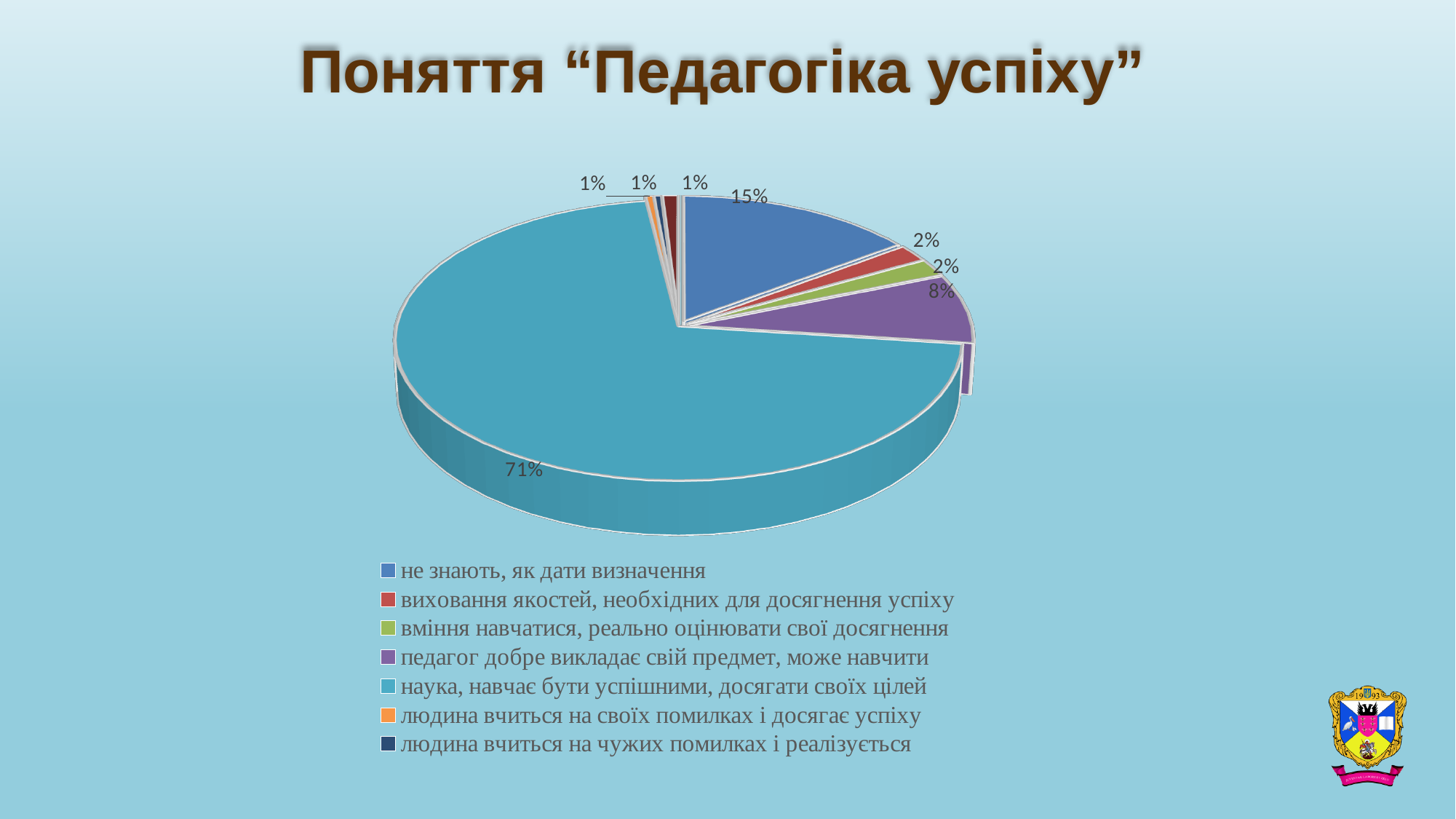
What share of the pie does "не знають, як дати визначення" have? 15% What is the difference between the share for "наука, навчає бути успішними, досягати своїх цілей" and the share for "не знають, як дати визначення"? 56% Which is larger: the share for "не знають, як дати визначення" or the share for "педагог добре викладає свій предмет, може навчити"? не знають, як дати визначення What share of the pie does "людина вчиться на своїх помилках і досягає успіху" have? 1% What colour is the slice for "педагог добре викладає свій предмет, може навчити"? purple How many entries does the chart legend list? 7 What is the title of the slide with the chart? Поняття “Педагогіка успіху” What kind of chart is shown on the slide? pie chart What share of the pie does "виховання якостей, необхідних для досягнення успіху" have? 2% Which category has the largest share of the pie? наука, навчає бути успішними, досягати своїх цілей